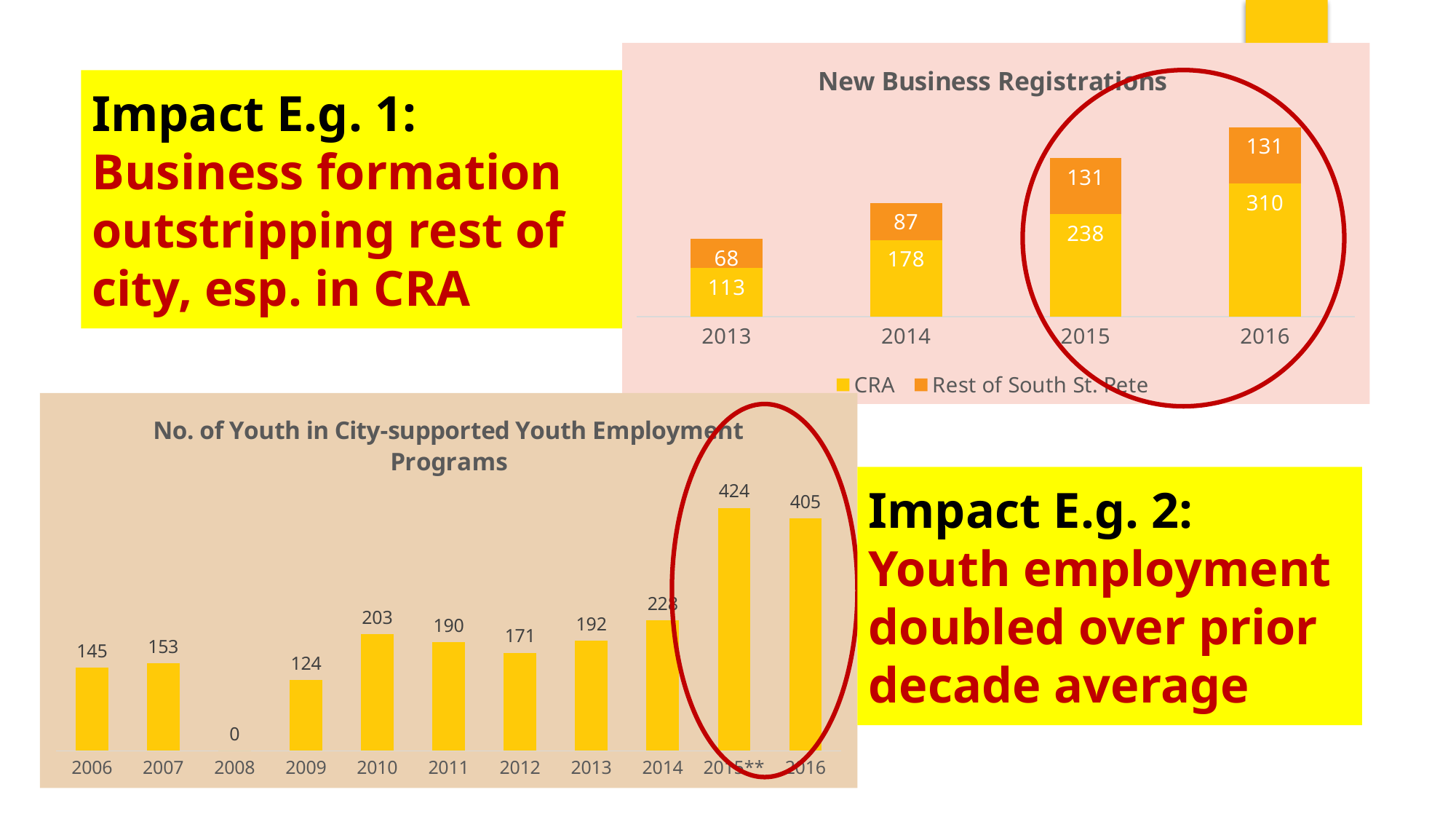
In the No. of Youth in City-supported Youth Employment Programs chart, what is the value for 2014? 228 In the New Business Registrations chart, do the CRA values rise or fall from 2013 to 2016? rise In the No. of Youth in City-supported Youth Employment Programs chart, which is larger, the value for 2010 or the value for 2013? 2010 In the No. of Youth in City-supported Youth Employment Programs chart, how many years are shown on the x axis? 11 In the No. of Youth in City-supported Youth Employment Programs chart, which year has the highest value? 2015** In the No. of Youth in City-supported Youth Employment Programs chart, which year has the lowest value? 2008 In the New Business Registrations chart, what is the Rest of South St. Pete value for 2014? 87 In the New Business Registrations chart, what is the total of the stacked bar for 2015? 369 In the New Business Registrations chart, how many series does the legend list? 2 In the New Business Registrations chart, what is the difference between the CRA values for 2016 and 2013? 197 What kind of chart is the No. of Youth in City-supported Youth Employment Programs chart? bar chart In the New Business Registrations chart, what is the CRA value for 2016? 310